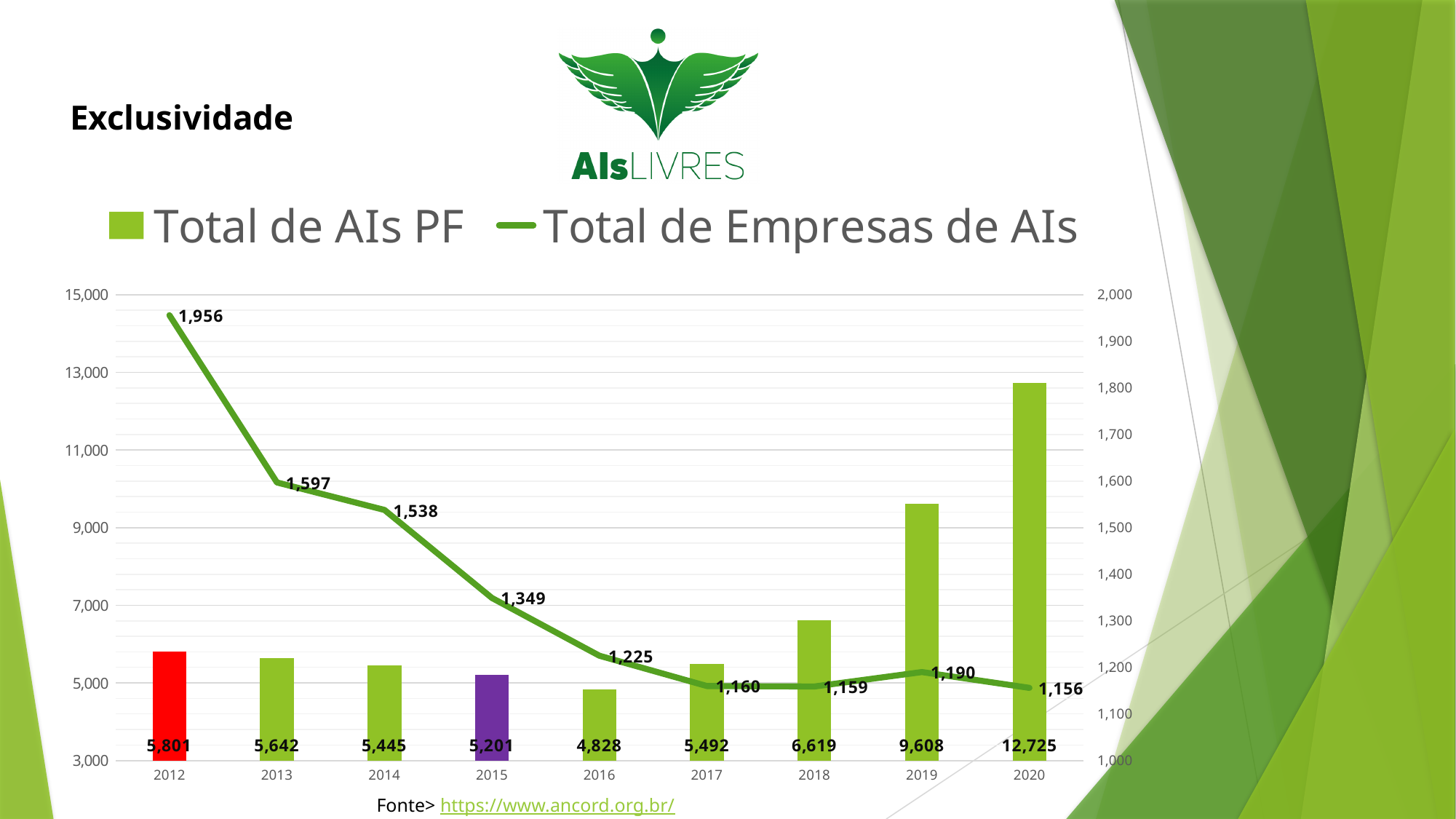
What is the value of Total de AIs PF for 2016? 4,828 What is the value of Total de Empresas de AIs for 2015? 1,349 How many series does the legend list? 2 Which year has the highest value for Total de Empresas de AIs? 2012 What is the value of Total de Empresas de AIs for 2012? 1,956 What is the value of Total de AIs PF for 2020? 12,725 Does the Total de Empresas de AIs line generally rise or fall from 2012 to 2017? fall Which year has the highest value for Total de AIs PF? 2020 Which year has the lowest value for Total de AIs PF? 2016 Which is larger, Total de AIs PF in 2012 or in 2013? 2012 How many years are shown on the x axis? 9 What is the difference between Total de AIs PF in 2020 and in 2019? 3,117